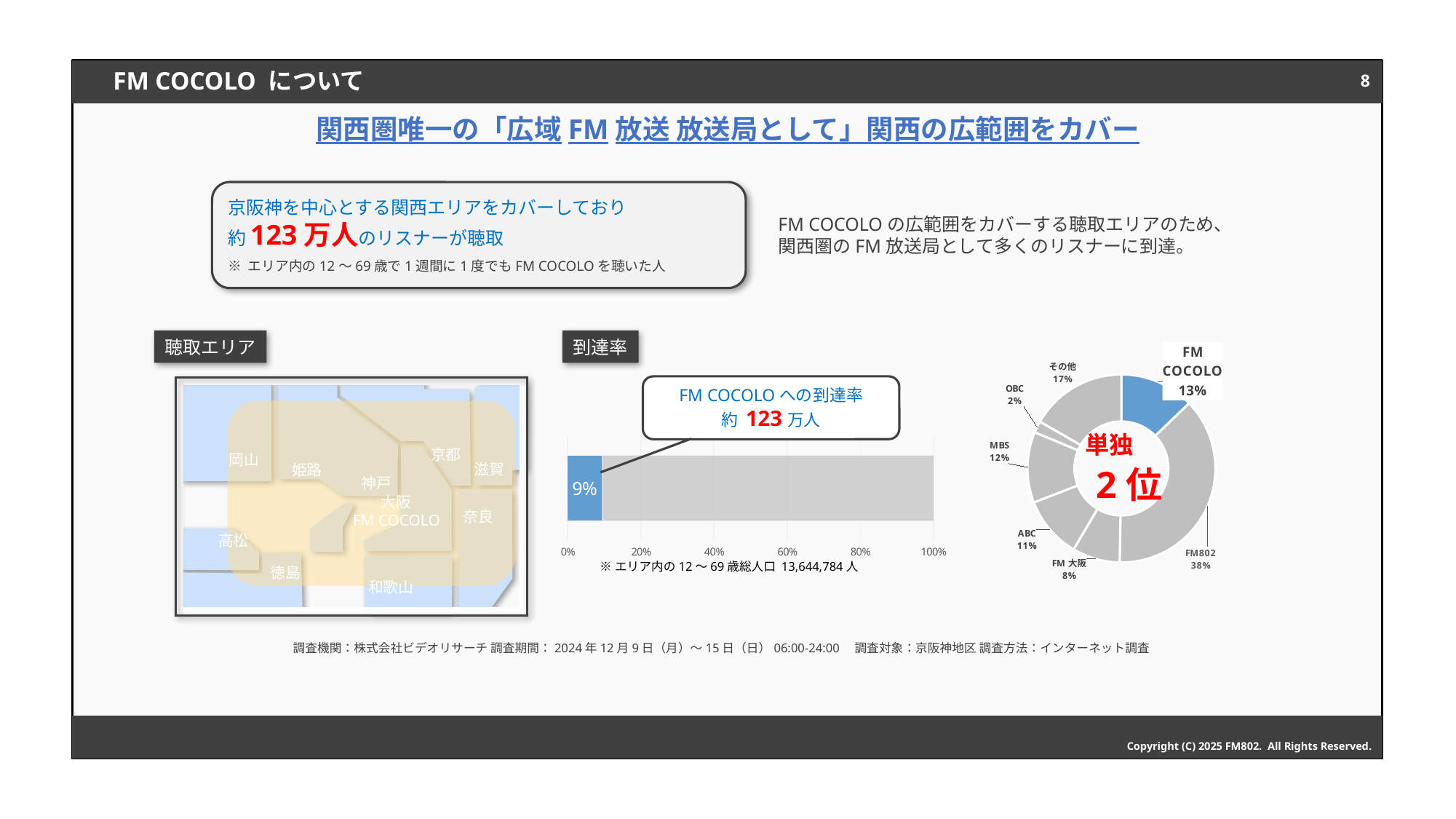
In the donut chart on the right, how many slices are labelled? 7 In the donut chart on the right, what is the difference between the shares of FM802 and FM COCOLO? 25% In the donut chart on the right, what share does FM802 have? 38% In the donut chart on the right, what share does MBS have? 12% In the 到達率 bar chart in the middle, what value is printed on the blue bar? 9% In the donut chart on the right, which station has the largest share? FM802 What kind of chart is the chart on the right showing station shares? Donut (pie) chart In the donut chart on the right, what share does FM COCOLO have? 13% In the donut chart on the right, which is larger, the share of ABC or the share of FM 大阪? ABC In the donut chart on the right, what text is printed in the centre of the ring? 単独 2位 In the donut chart on the right, which station has the smallest share? OBC In the 到達率 bar chart in the middle, is the blue bar's value greater or less than 20%? less